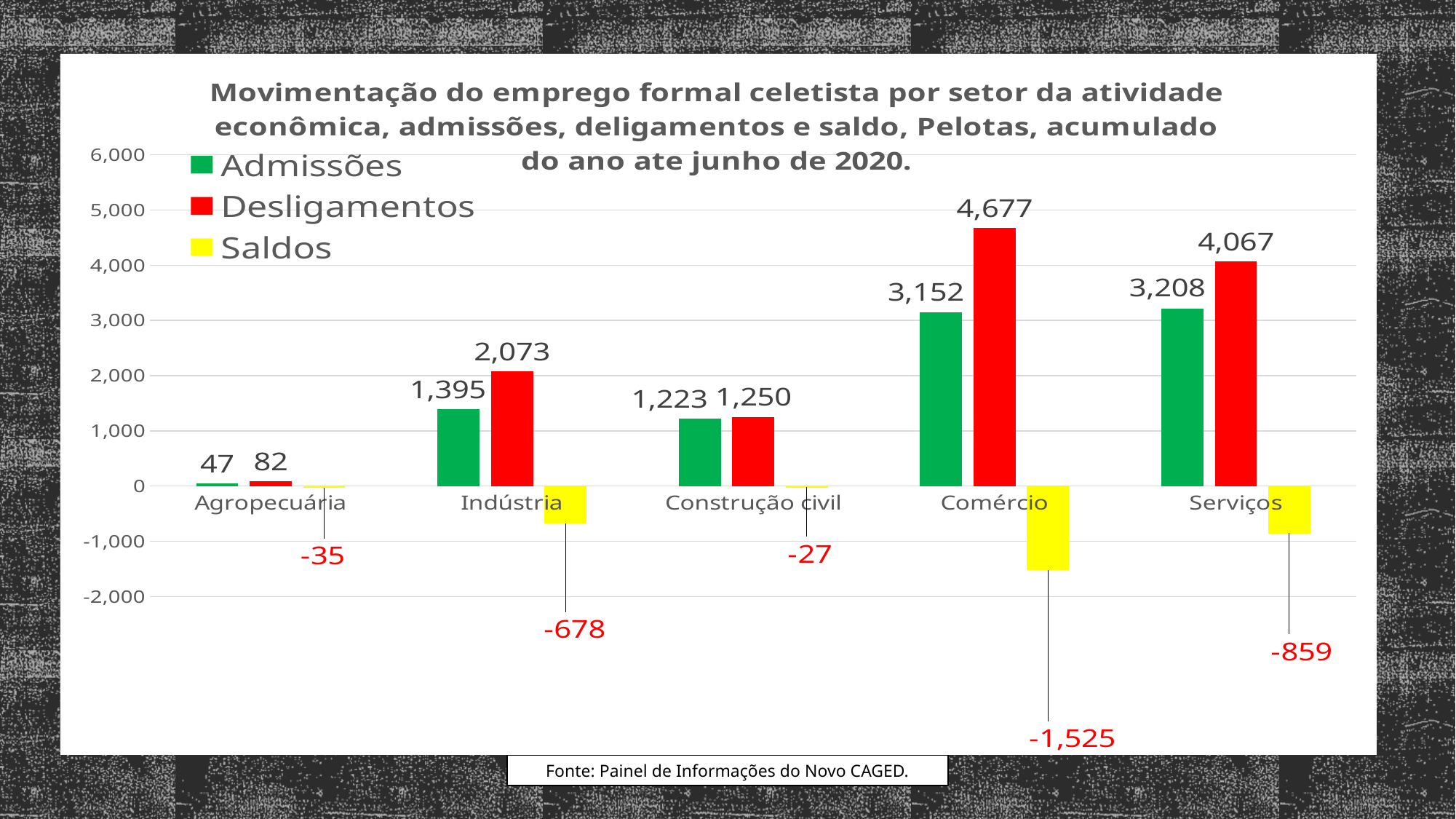
How many sectors are shown on the x axis? 5 Which sector has the lowest Admissões value? Agropecuária What is the value of Desligamentos for Serviços? 4,067 Which sector has the highest Desligamentos value? Comércio What colour represents the Saldos series? Yellow What kind of chart is shown on the slide? Bar chart Which is larger for Serviços: Admissões or Desligamentos? Desligamentos How many series does the legend list? 3 What is the value of Admissões for Comércio? 3,152 What is the difference between Desligamentos and Admissões for Indústria? 678 What is the Saldos value for Comércio? -1,525 What is the Saldos value for Indústria? -678